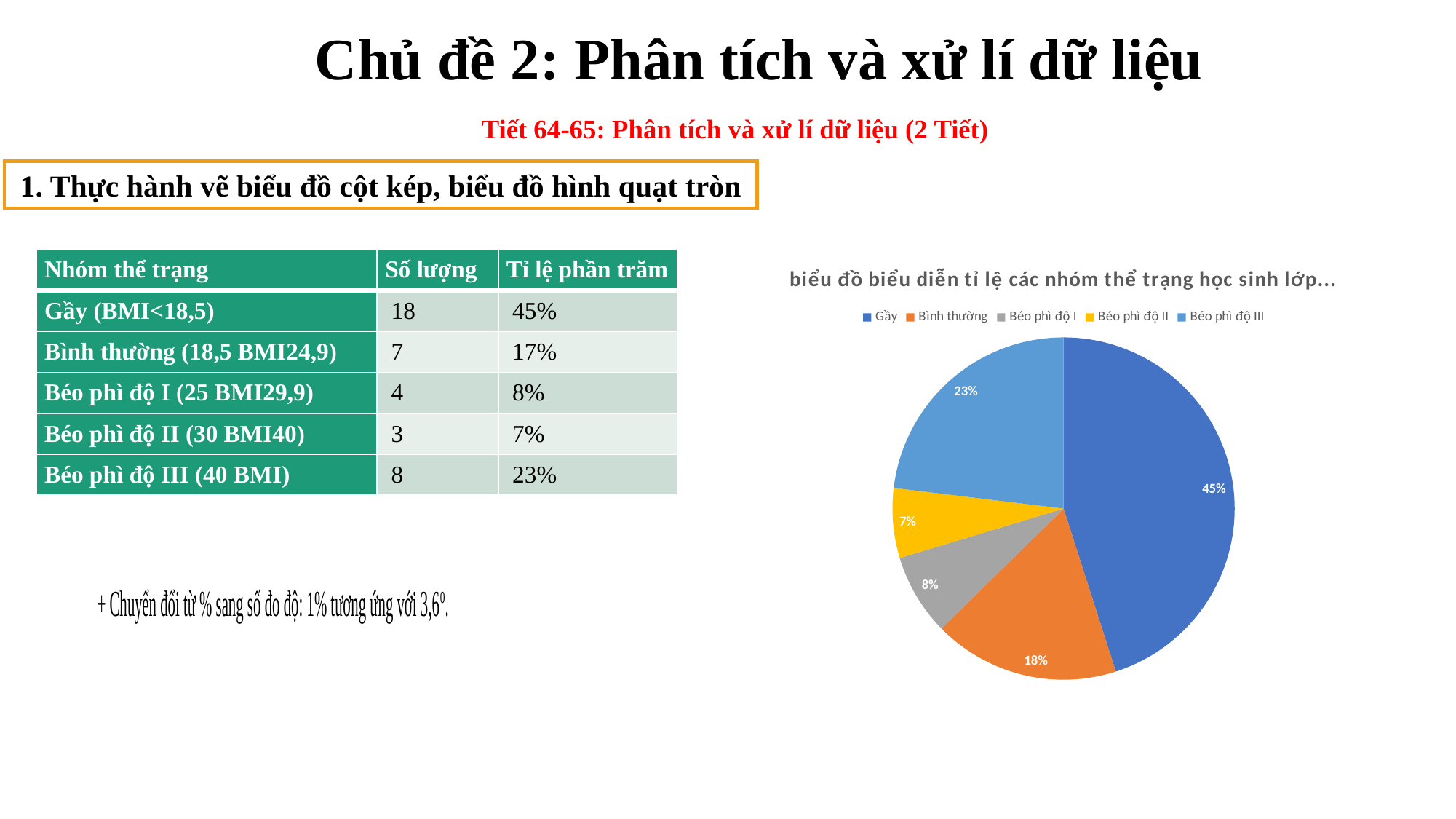
What percentage does the Béo phì độ II slice show in the pie chart? 7% Which group has the largest slice in the pie chart? Gầy What percentage does the Gầy slice show in the pie chart? 45% What percentage does the Béo phì độ I slice show in the pie chart? 8% What colour is the Béo phì độ II slice in the pie chart? yellow Which slice is larger in the pie chart, Bình thường or Béo phì độ III? Béo phì độ III What is the difference in percentage points between the Gầy slice and the Béo phì độ III slice in the pie chart? 22% Which group has the smallest slice in the pie chart? Béo phì độ II How many slices does the pie chart have? 5 What percentage does the Béo phì độ III slice show in the pie chart? 23% What percentage does the Bình thường slice show in the pie chart? 18% What kind of chart is shown on the slide? pie chart